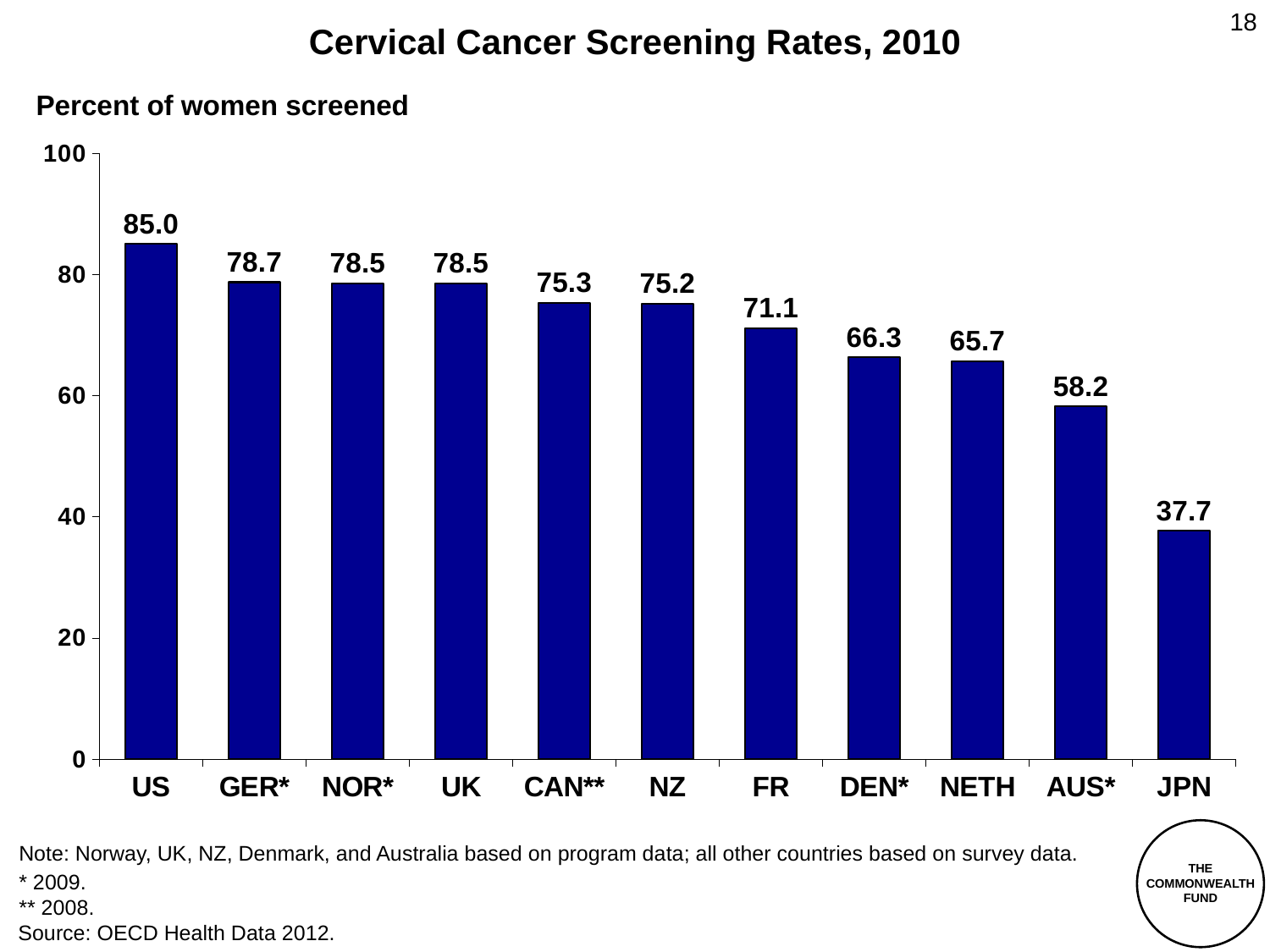
How many countries are shown in the chart? 11 Which country has the lowest screening rate? JPN What is the cervical cancer screening rate for the US? 85.0 What is the title of the chart? Cervical Cancer Screening Rates, 2010 Which has a higher value, AUS* or NETH? NETH What is the value shown for JPN? 37.7 What kind of chart is shown on the slide? Bar chart Is the value for AUS* greater or less than 60? less Which country has the highest screening rate? US What is the difference between the values for DEN* and NETH? 0.6 What is the difference between the values for US and JPN? 47.3 What is the value shown for FR? 71.1